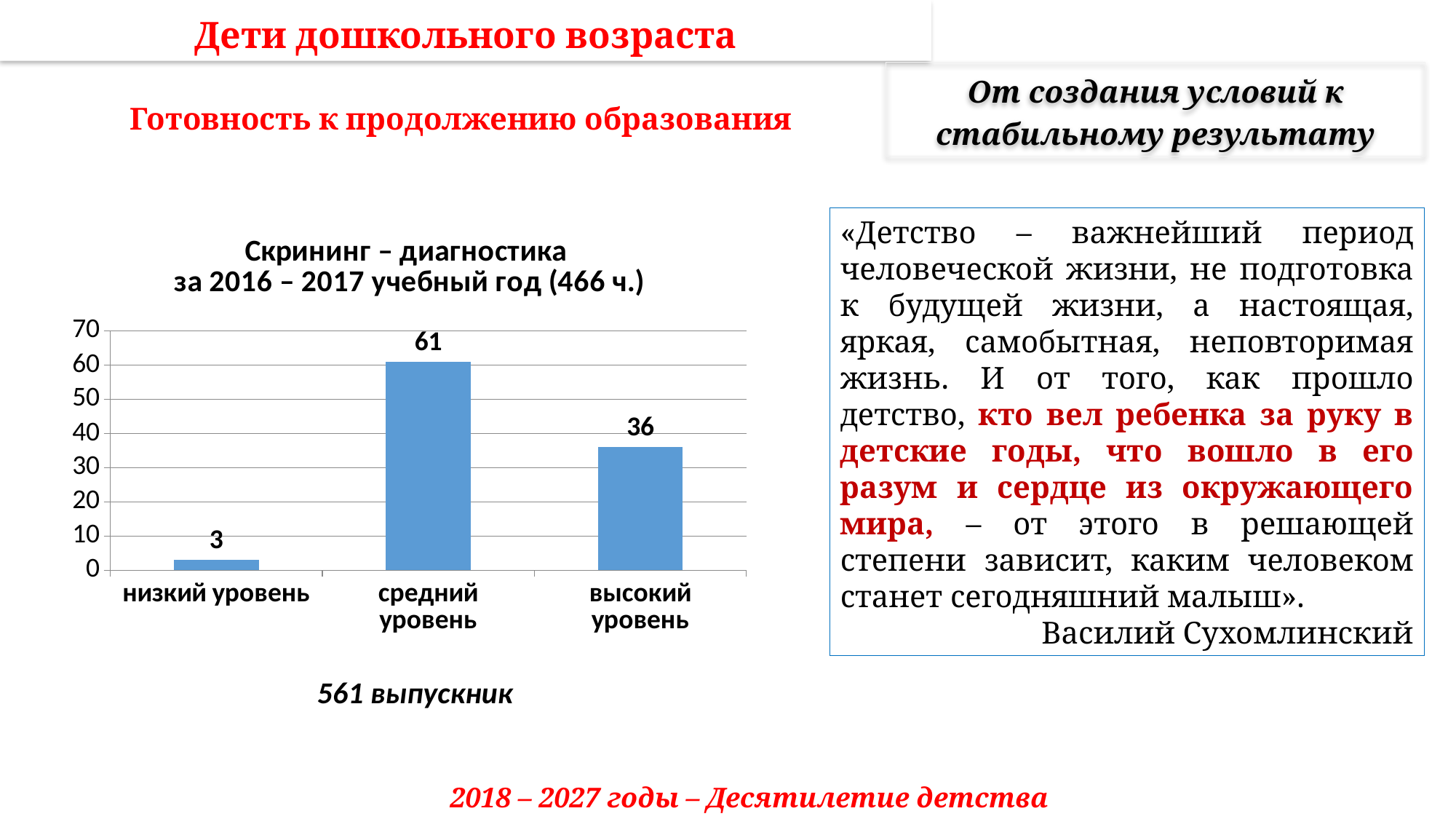
What is the difference between the values for высокий уровень and низкий уровень? 33 Is the value for средний уровень greater or less than 50? greater What is the value for высокий уровень? 36 How many categories are shown on the x axis? 3 What kind of chart is shown on the slide? bar chart What is the value for низкий уровень? 3 Which category has the lowest value? низкий уровень Which category has the highest value? средний уровень What is the difference between the values for средний уровень and высокий уровень? 25 Which is larger, the value for высокий уровень or the value for низкий уровень? высокий уровень What is the title of the chart? Скрининг – диагностика за 2016 – 2017 учебный год (466 ч.) What is the value for средний уровень? 61